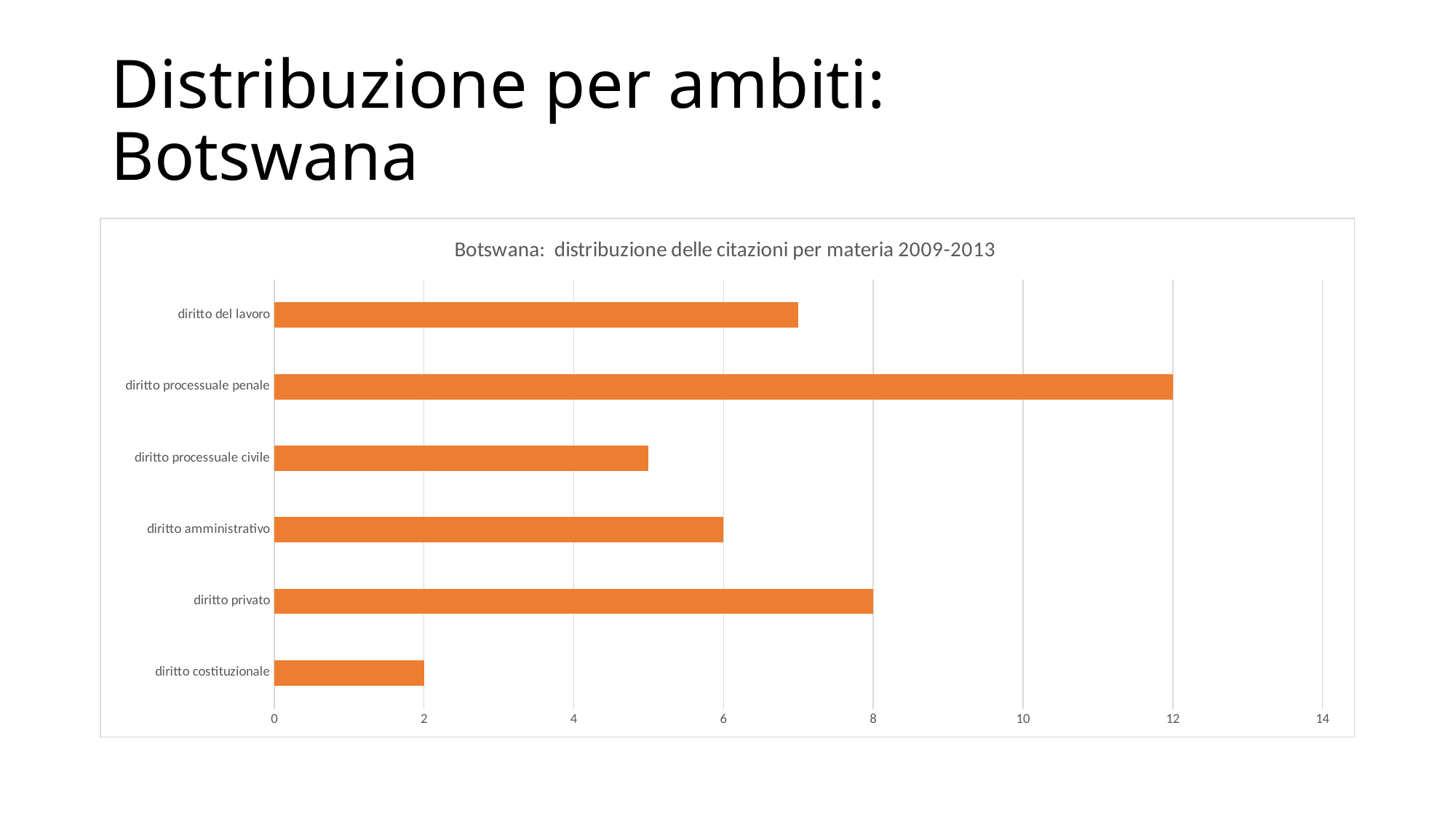
Is the value for diritto del lavoro greater or less than 6? greater What type of chart is shown on the slide? bar chart Which category has the highest value? diritto processuale penale How many categories are shown in the chart? 6 What is the value for diritto privato? 8 What is the value for diritto amministrativo? 6 What is the difference between the values for diritto processuale penale and diritto privato? 4 What is the value for diritto costituzionale? 2 What is the value for diritto processuale penale? 12 What is the title of the chart? Botswana: distribuzione delle citazioni per materia 2009-2013 Which is larger, the value for diritto processuale civile or the value for diritto privato? diritto privato Which category has the lowest value? diritto costituzionale